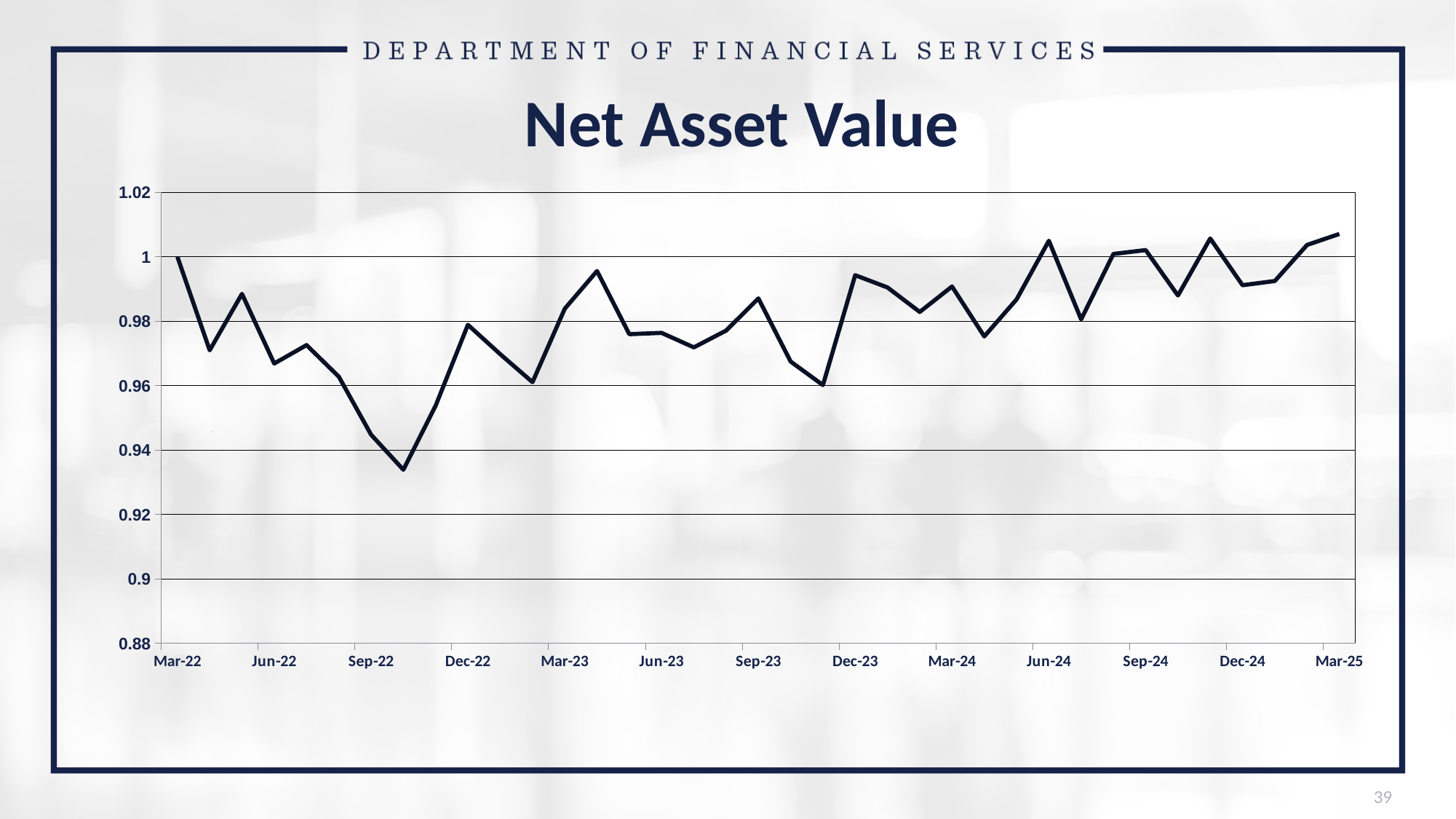
What kind of chart is shown on the slide? line chart Which is larger, the value for Mar-22 or the value for Jun-22? Mar-22 Is the value for Dec-23 greater or less than 0.98? greater Is the value for Jun-22 greater or less than 0.98? less What is the title of the chart? Net Asset Value Is the value for Dec-24 greater or less than 1? less Which is larger, the value for Dec-23 or the value for Jun-23? Dec-23 What is the value for Mar-22? 1 Does the line rise or fall between Sep-22 and Dec-22? rises How many dates are labeled on the x axis of the chart? 13